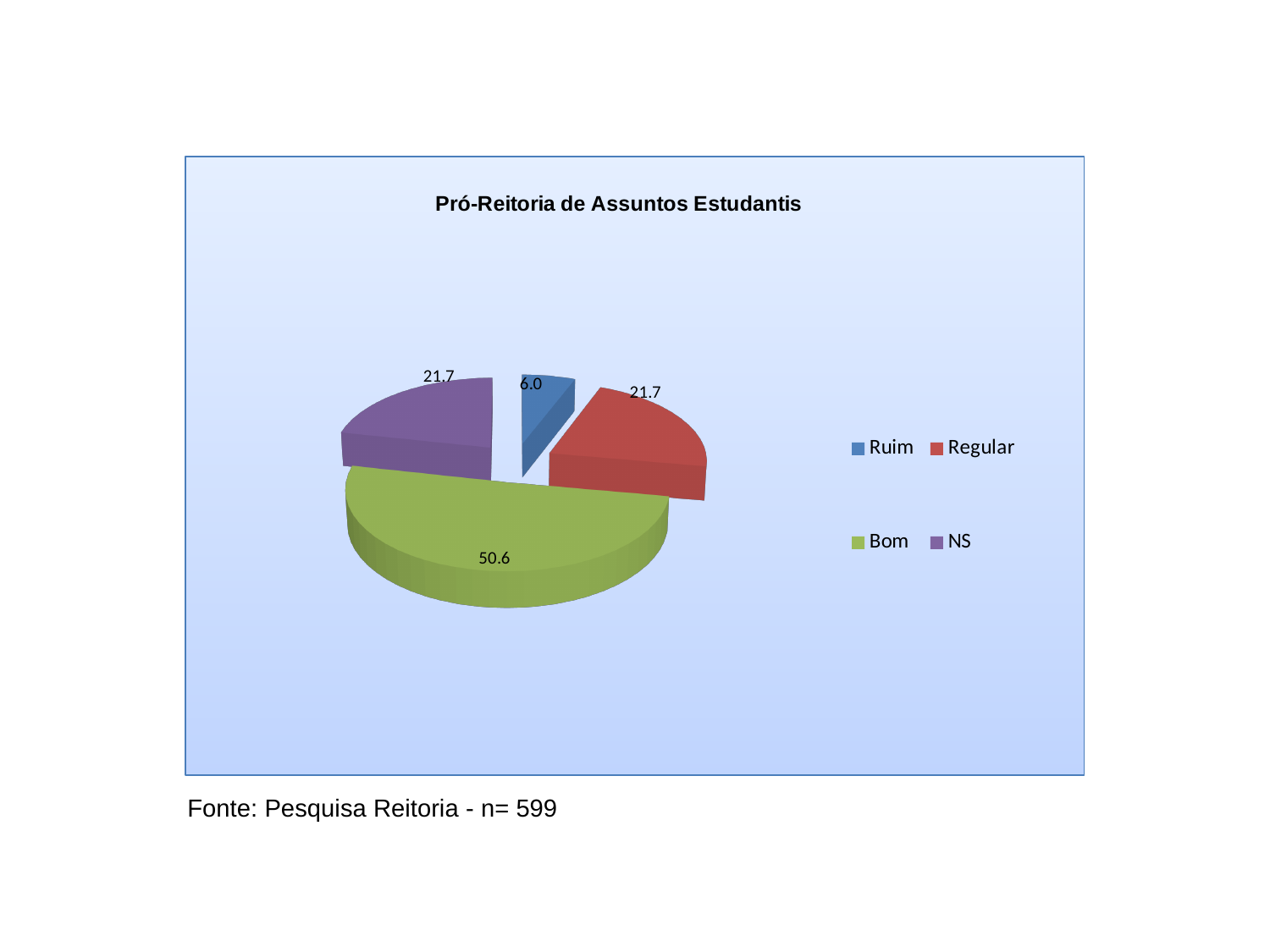
What is the value for Bom? 50.6 What is the value for NS? 21.7 How many categories does the legend list? 4 What is the title of the chart? Pró-Reitoria de Assuntos Estudantis Which category has the largest slice? Bom Which category has the smallest slice? Ruim What is the value for Regular? 21.7 What type of chart is shown on the slide? Pie chart What is the difference between the values for Regular and Ruim? 15.7 Which is larger, the value for Bom or the value for NS? Bom What is the value for Ruim? 6.0 What is the difference between the values for Bom and Regular? 28.9